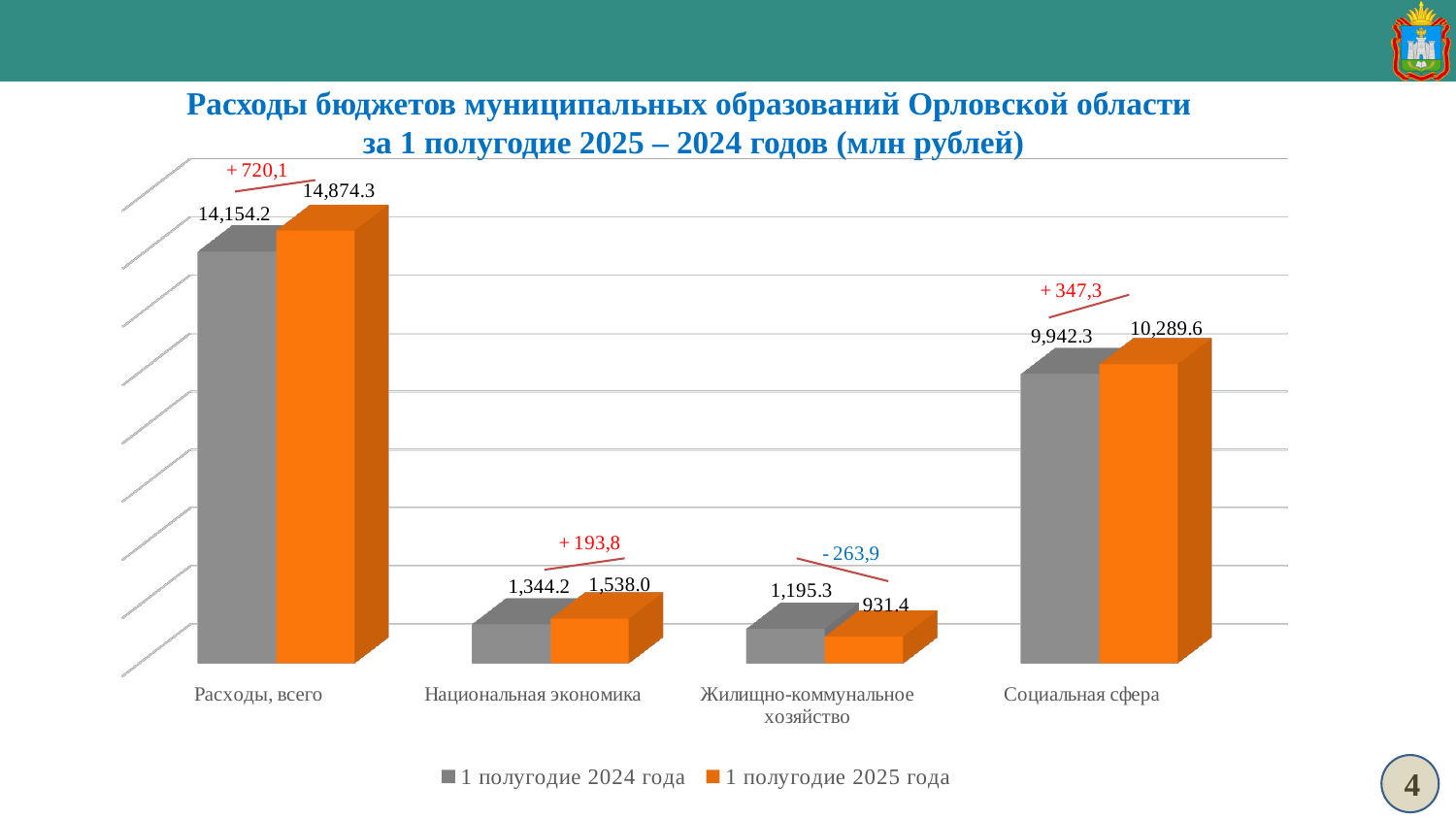
What is the value for Национальная экономика in 1 полугодие 2024 года? 1,344.2 What is the value for Жилищно-коммунальное хозяйство in 1 полугодие 2025 года? 931.4 For Жилищно-коммунальное хозяйство, which is larger: the 1 полугодие 2024 года value or the 1 полугодие 2025 года value? 1 полугодие 2024 года What is the difference between the 2025 and 2024 values for Социальная сфера, as annotated on the chart? + 347,3 Excluding Расходы, всего, which category has the highest value in 1 полугодие 2024 года? Социальная сфера How many series does the legend list? 2 Which category has the lowest value in 1 полугодие 2025 года? Жилищно-коммунальное хозяйство What change is annotated above the Жилищно-коммунальное хозяйство bars? - 263,9 What kind of chart is shown on the slide? Bar chart What is the value for Социальная сфера in 1 полугодие 2024 года? 9,942.3 How many categories are shown on the x axis? 4 What is the value for Расходы, всего in 1 полугодие 2025 года? 14,874.3